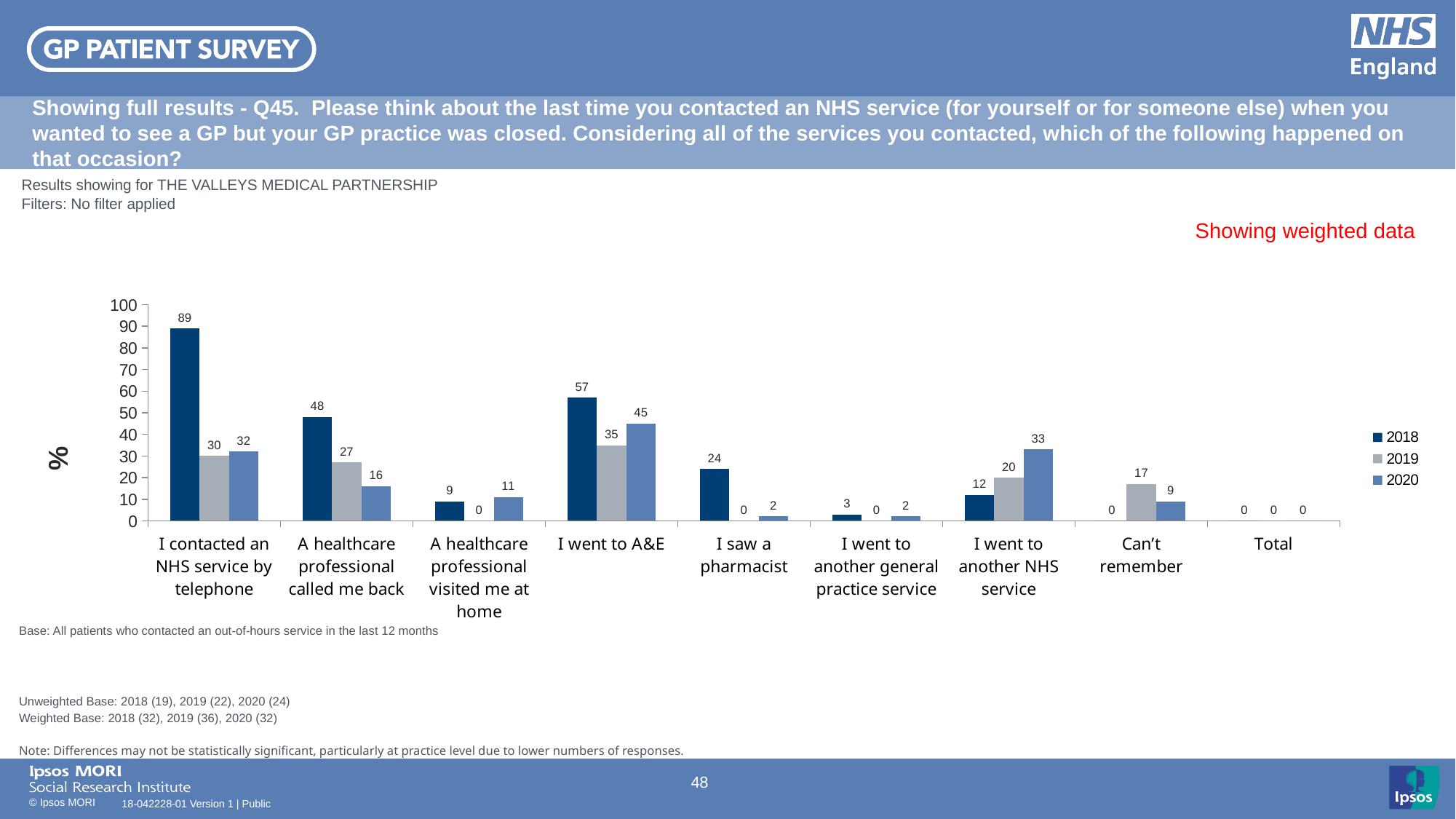
What is the difference between the 2018 and 2019 values for 'A healthcare professional called me back'? 21 What is the 2019 value for 'Can't remember'? 17 What is the 2018 value for 'I contacted an NHS service by telephone'? 89 Which category has the highest 2018 value? I contacted an NHS service by telephone What label is shown on the y axis? % What is the 2020 value for 'I went to A&E'? 45 What is the 2019 value for 'I went to another NHS service'? 20 How many categories are shown on the x axis? 9 How many series does the legend list? 3 Which is larger for 'I went to another NHS service': the 2018 value or the 2020 value? 2020 Which category has the highest 2020 value? I went to A&E What kind of chart is shown on the slide? Bar chart